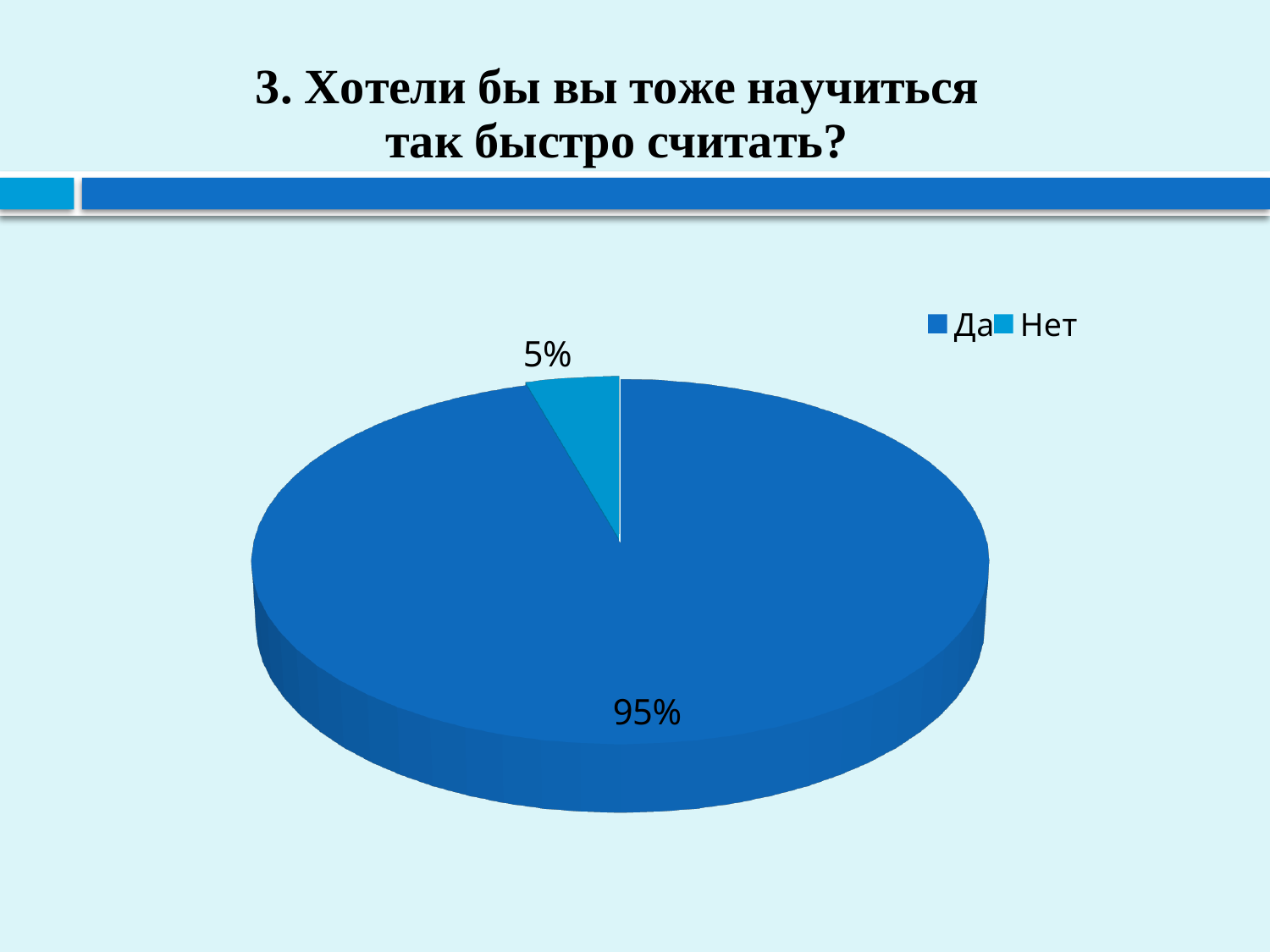
Which category has the smallest slice of the pie? Нет How many entries does the legend list? 2 What is the difference in percentage points between the "Да" and "Нет" slices? 90 Which is larger, the "Да" slice or the "Нет" slice? Да What share of the pie does "Нет" have? 5% How many categories does the pie chart show? 2 Which legend entry is listed first? Да What share of the pie does "Да" have? 95% What kind of chart is shown on the slide? pie chart Which category has the largest slice of the pie? Да What is the title of the slide above the chart? 3. Хотели бы вы тоже научиться так быстро считать?